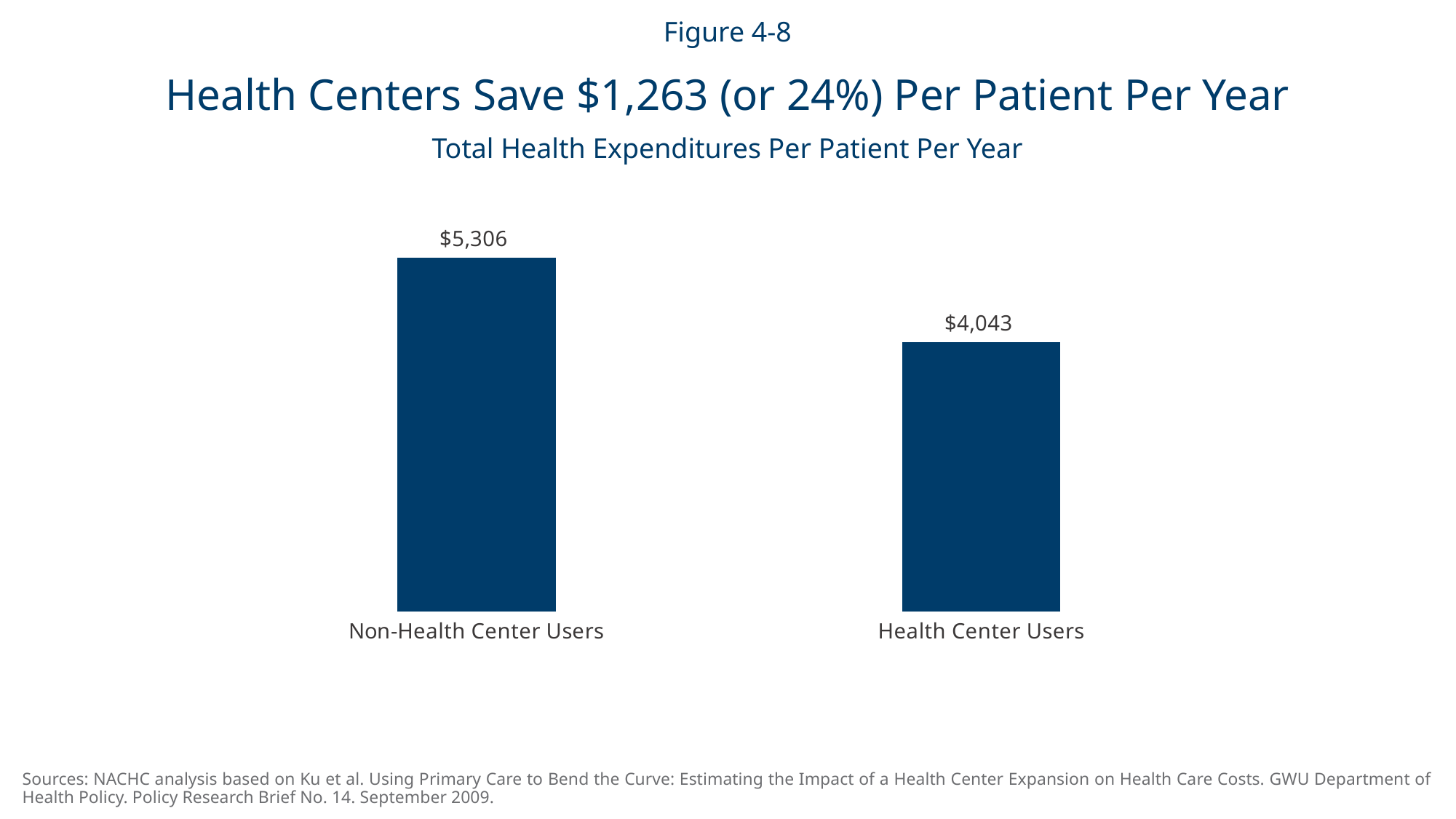
What is the total health expenditure per patient per year for Health Center Users? $4,043 How many categories are shown in the chart? 2 What is the difference in total health expenditures per patient per year between Non-Health Center Users and Health Center Users? $1,263 Which category has the lower total health expenditure per patient per year? Health Center Users What is the subtitle of the chart? Total Health Expenditures Per Patient Per Year Is the value for Health Center Users larger or smaller than the value for Non-Health Center Users? smaller Which category has the higher total health expenditure per patient per year? Non-Health Center Users What kind of chart is shown on the slide? bar chart What figure number is shown on the slide? Figure 4-8 What is the total health expenditure per patient per year for Non-Health Center Users? $5,306